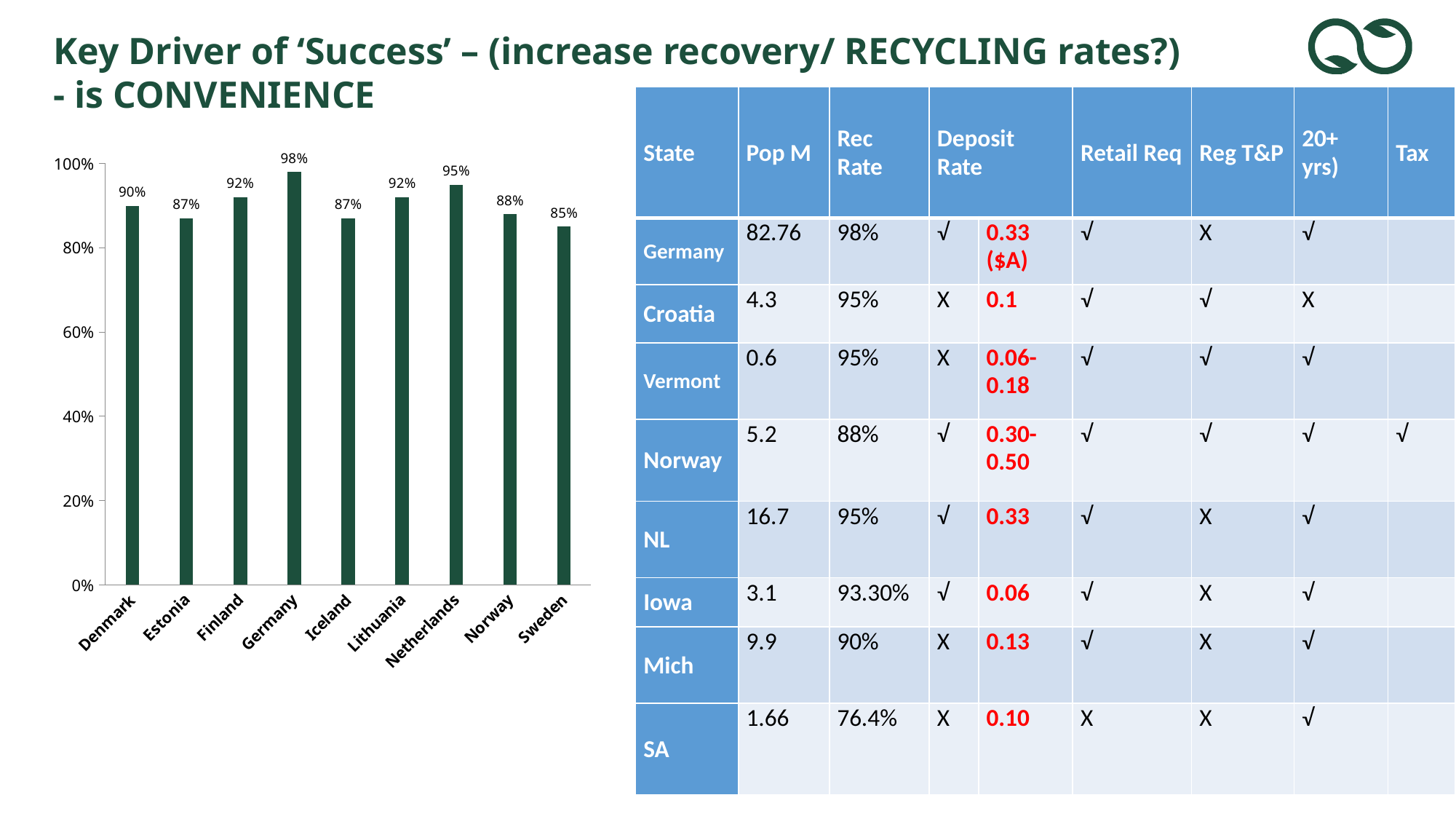
Which has a higher value in the bar chart, Denmark or Finland? Finland What is the value for Netherlands in the bar chart? 95% Is the value for Estonia in the bar chart greater or less than 80%? greater What is the value for Sweden in the bar chart? 85% Which country has the highest value in the bar chart? Germany Which country has the lowest value in the bar chart? Sweden What type of chart is shown on the left of the slide? bar chart What is the value for Germany in the bar chart? 98% Which two countries in the bar chart both have a value of 87%? Estonia and Iceland What is the difference between the values for Netherlands and Norway in the bar chart? 7% What is the difference between the values for Germany and Sweden in the bar chart? 13% How many countries are shown in the bar chart? 9